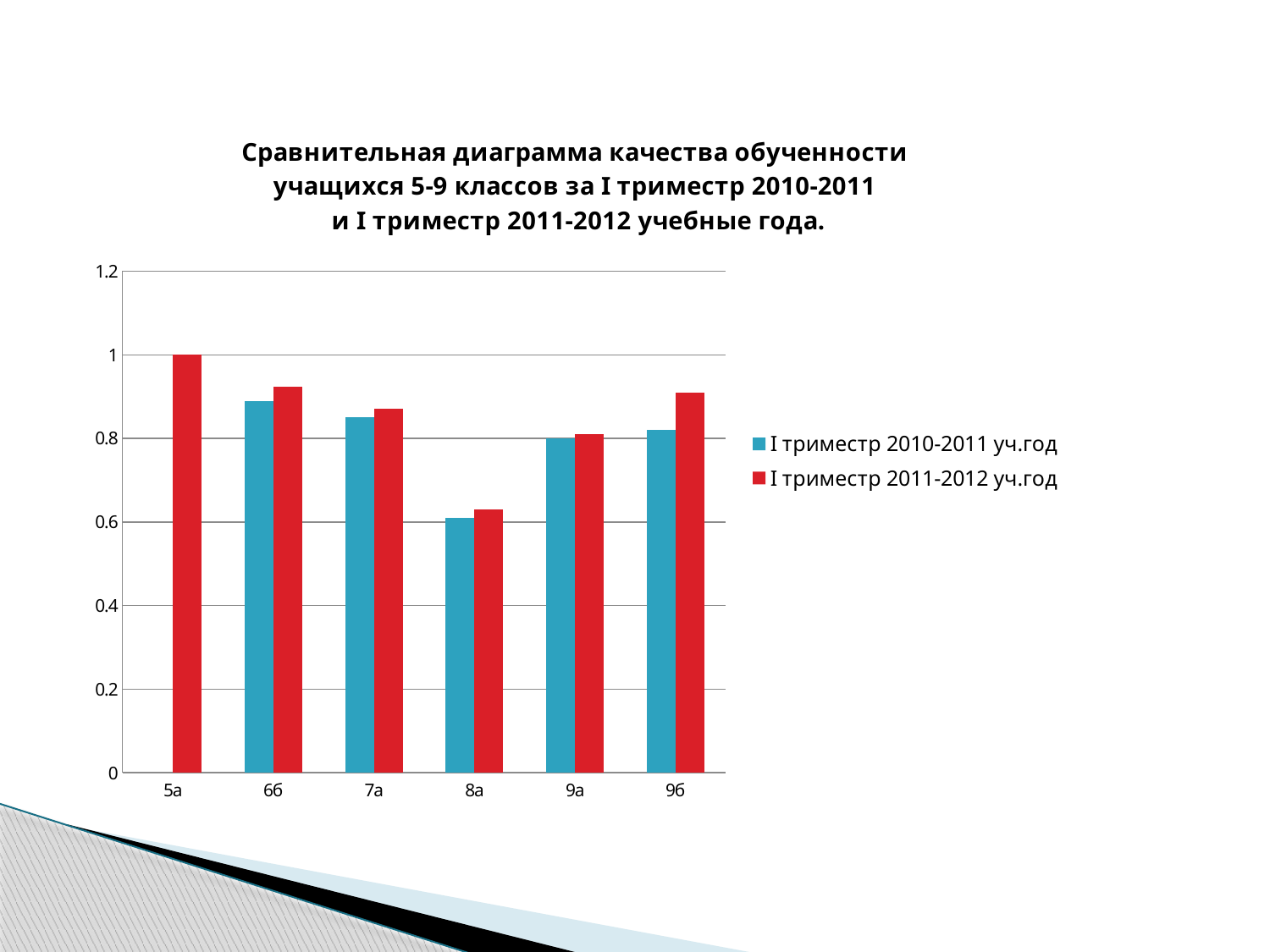
Which class has the highest value in the I триместр 2011-2012 уч.год series? 5а Is the value for 6б in the I триместр 2011-2012 уч.год series greater or less than 0.8? greater How many classes (categories) are shown on the x axis? 6 Which class has the lowest value in the I триместр 2011-2012 уч.год series? 8а What kind of chart is shown on the slide? bar chart Is the value for 7а in the I триместр 2010-2011 уч.год series greater or less than 0.8? greater What is the value for 5а in the I триместр 2011-2012 уч.год series? 1 Is the value for 8а in the I триместр 2010-2011 уч.год series greater or less than 0.8? less How many series does the legend list? 2 For 9б, which series has the larger value: I триместр 2010-2011 уч.год or I триместр 2011-2012 уч.год? I триместр 2011-2012 уч.год Which colour represents the I триместр 2011-2012 уч.год series? red Which class has the lowest value in the I триместр 2010-2011 уч.год series? 8а